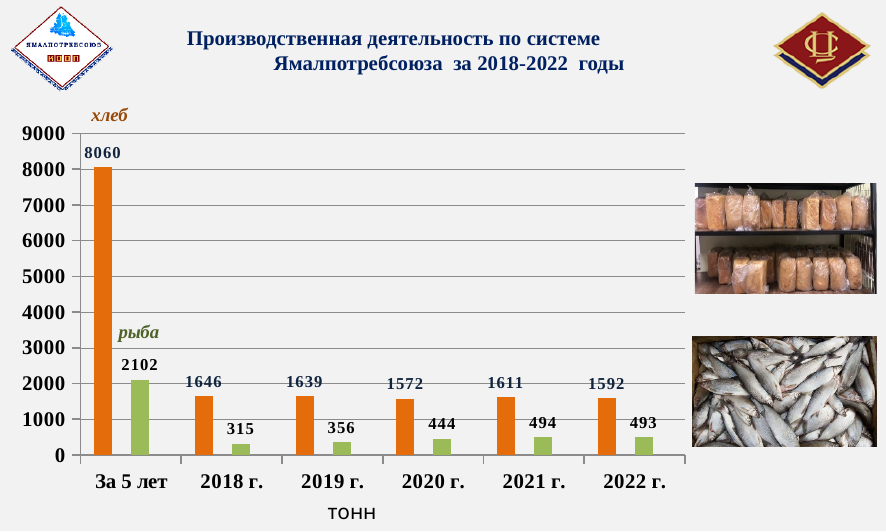
What is the value for рыба in 2020 г.? 444 What is the value for рыба in 2022 г.? 493 What unit is indicated below the x axis of the chart? тонн What is the difference between the хлеб value and the рыба value in 2021 г.? 1117 How many data series does the chart show? 2 Which is larger: the рыба value in 2019 г. or in 2020 г.? 2020 г. What is the value for хлеб for За 5 лет? 8060 Among the individual years 2018 г. to 2022 г., which year has the highest value for хлеб? 2018 г. Among the individual years 2018 г. to 2022 г., which year has the lowest value for рыба? 2018 г. What kind of chart is shown on the slide? bar chart What is the value for хлеб in 2018 г.? 1646 How many categories are shown on the x axis? 6